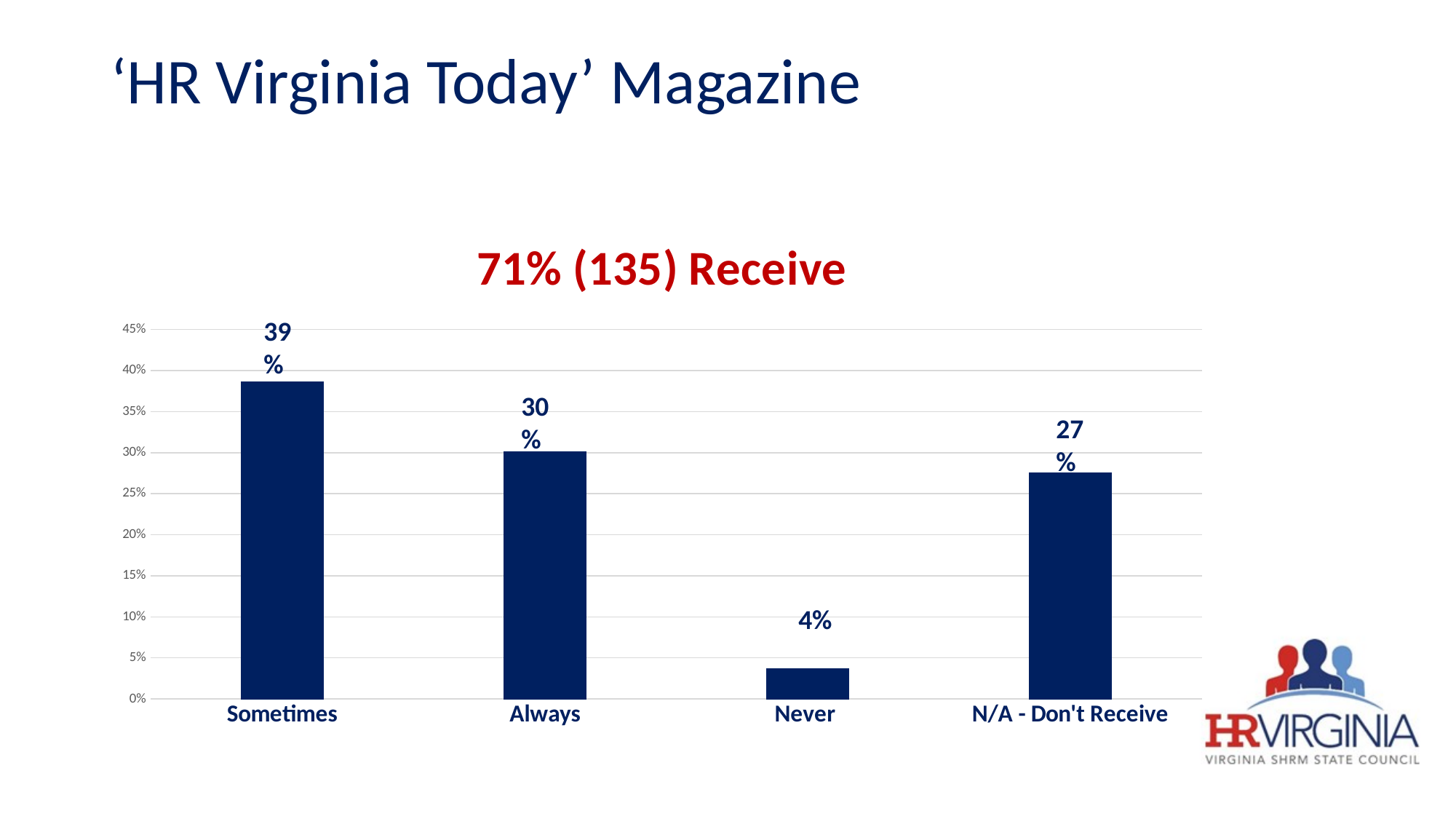
Which category has the lowest value? Never What is the value for Always? 30% What is the value for N/A - Don't Receive? 27% What is the value for Never? 4% What is the difference between the values for Sometimes and Always? 9% How many categories are shown on the x axis? 4 What kind of chart is shown on the slide? Bar chart Which is larger, the value for Always or the value for N/A - Don't Receive? Always What is the difference between the values for Always and N/A - Don't Receive? 3% What is the value for Sometimes? 39% What is the red text shown above the chart? 71% (135) Receive Which category has the highest value? Sometimes